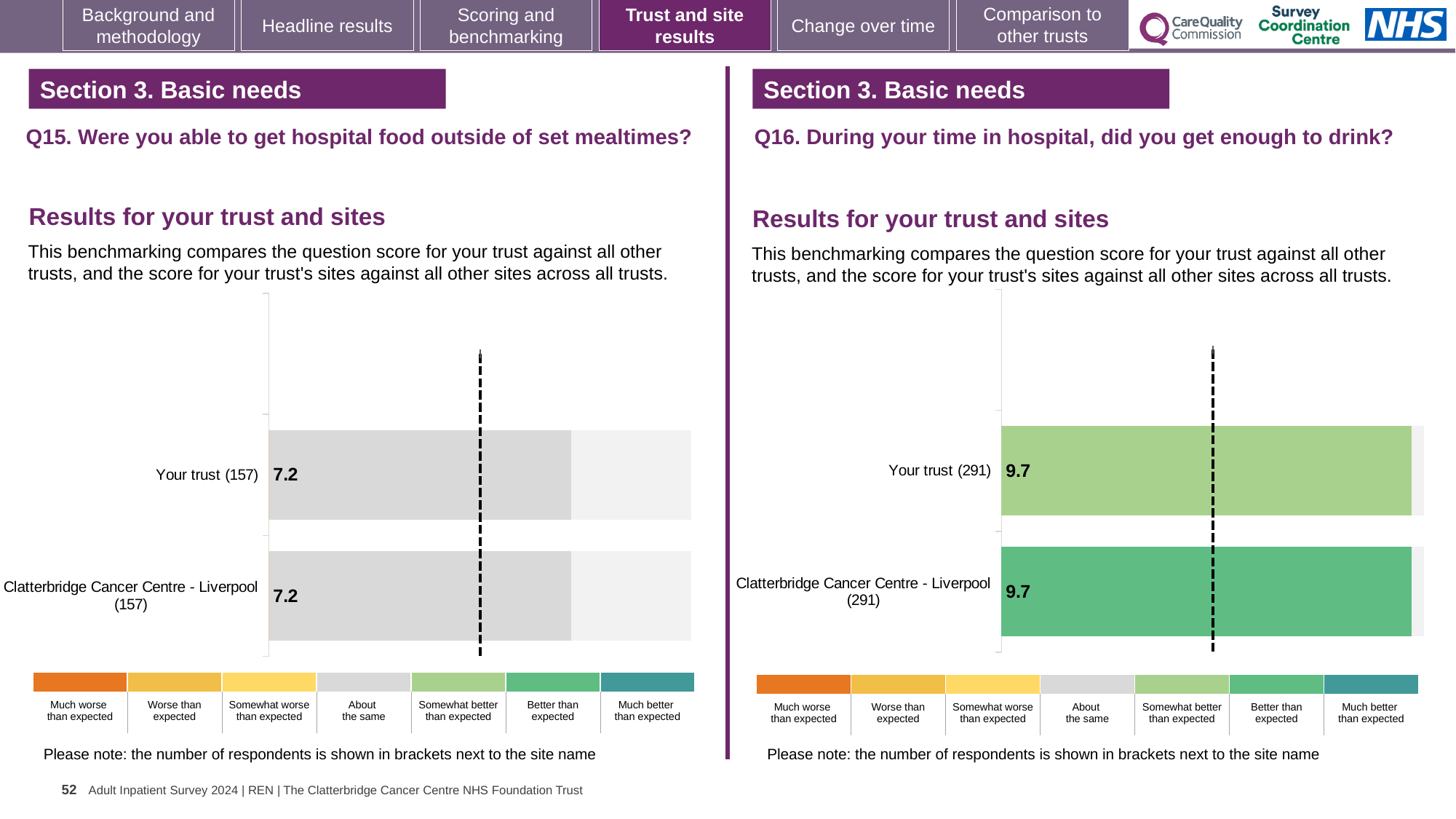
On the Q15 chart (left), how many respondents are shown in brackets for Your trust? 157 On the Q15 chart (left), what is the score for Clatterbridge Cancer Centre - Liverpool? 7.2 On the Q16 chart (right), how many respondents are shown in brackets for Clatterbridge Cancer Centre - Liverpool? 291 What kind of chart is the Q16 chart (right)? Bar chart On the Q16 chart (right), what is the score for Your trust? 9.7 On the Q15 chart (left), which benchmark category does the colour of the Your trust bar correspond to in the key? About the same On the Q15 chart (left), what is the score for Your trust? 7.2 On the Q16 chart (right), what is the difference between the score for Your trust and the score for Clatterbridge Cancer Centre - Liverpool? 0.0 On the Q16 chart (right), which benchmark category does the colour of the Clatterbridge Cancer Centre - Liverpool bar correspond to in the key? Better than expected On the Q15 chart (left), what is the difference between the score for Your trust and the score for Clatterbridge Cancer Centre - Liverpool? 0.0 On the Q16 chart (right), what is the score for Clatterbridge Cancer Centre - Liverpool? 9.7 How many bars are plotted on the Q15 chart (left)? 2